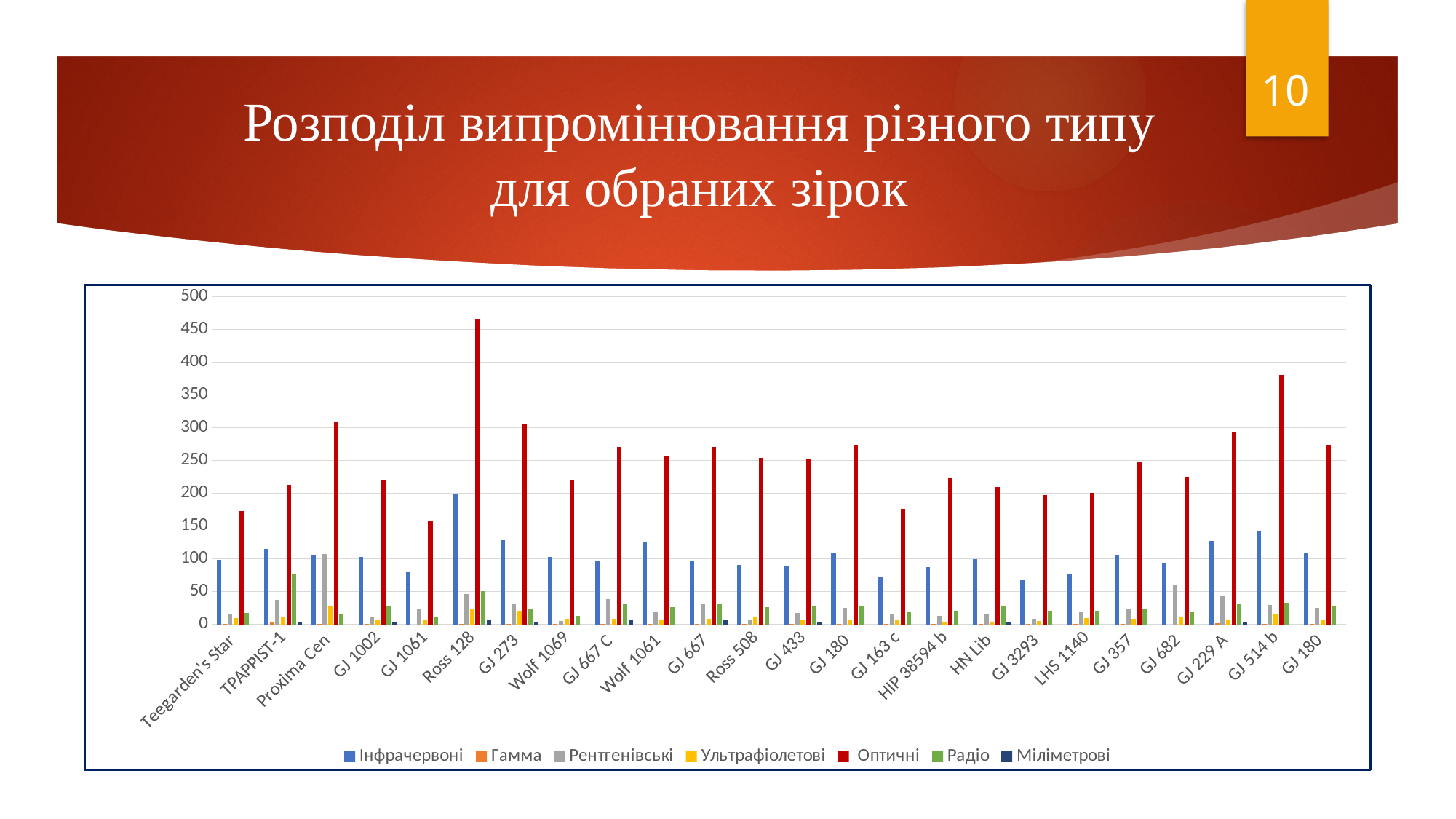
Is the Радіо value for TRAPPIST-1 greater or less than 50? greater How many stars (categories) are shown along the x axis? 24 Is the Оптичні value for Teegarden's Star greater or less than 200? less Which star has the highest value for the Оптичні series? Ross 128 What colour represents the Оптичні series in the chart? red What kind of chart is shown on the slide? bar chart Which is larger: the Оптичні value for Teegarden's Star or the Оптичні value for TRAPPIST-1? TRAPPIST-1 Is the Оптичні value for GJ 514 b greater or less than 350? greater How many series does the legend list? 7 Which star has the highest value for the Інфрачервоні series? Ross 128 Which is larger: the Оптичні value for Ross 128 or the Оптичні value for GJ 514 b? Ross 128